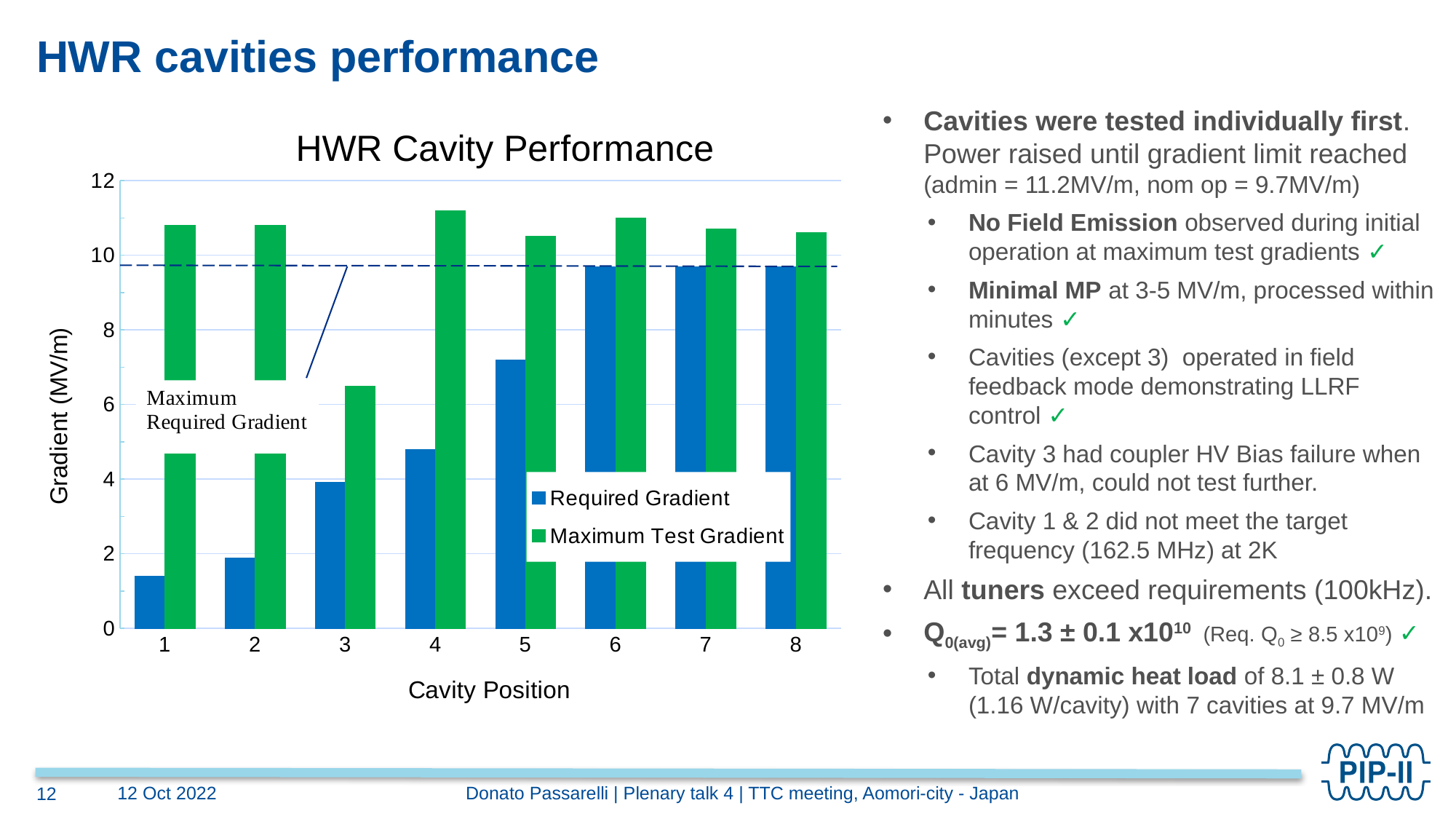
Which cavity position has the lowest Maximum Test Gradient? 3 What kind of chart is shown on the slide? bar chart Is the Required Gradient for cavity position 1 greater or less than 2 MV/m? less Which has the larger Required Gradient: cavity position 2 or cavity position 5? cavity position 5 How many series does the legend of the HWR Cavity Performance chart list? 2 How many cavity positions are shown on the x axis of the chart? 8 Which cavity position has the lowest Required Gradient? 1 Does the Required Gradient rise or fall as cavity position increases from 1 to 8? rise For cavity position 3, which is larger: the Required Gradient or the Maximum Test Gradient? Maximum Test Gradient Is the Maximum Test Gradient for cavity position 1 greater or less than 10 MV/m? greater What is the label of the y axis of the chart? Gradient (MV/m) Is the Required Gradient for cavity position 5 greater or less than 6 MV/m? greater